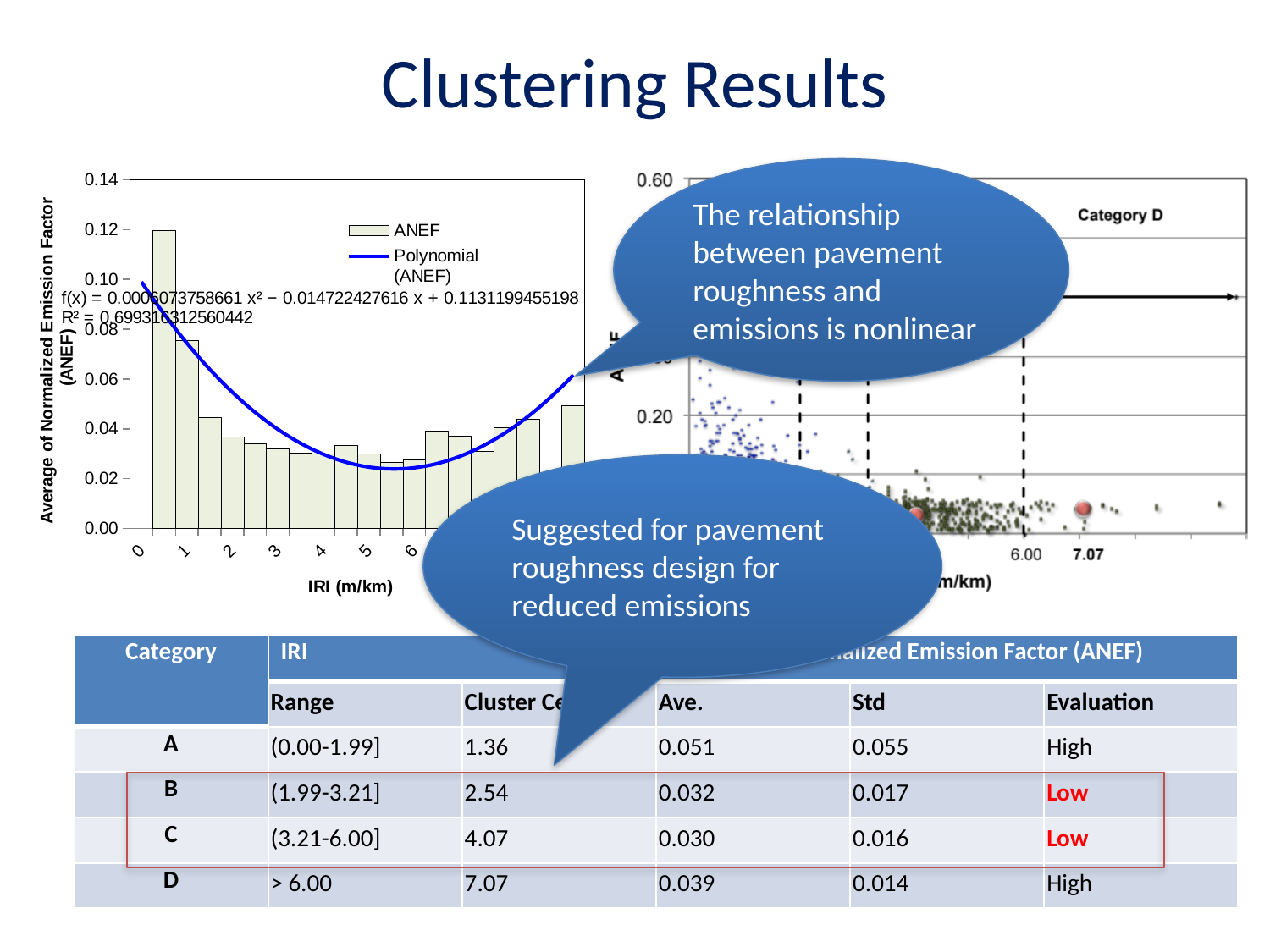
What kind of chart is the right chart on the slide? scatter plot What R² value is printed for the polynomial fit on the left chart? 0.699316312560442 On the left chart, is the ANEF bar at about IRI 5 greater or less than 0.04? less What are the two legend entries on the left chart? ANEF and Polynomial (ANEF) On the left chart, is the value of the first (tallest) ANEF bar near IRI 0 greater or less than 0.10? greater How many series does the legend of the left chart list? 2 On the left chart, do the ANEF bars generally rise or fall as IRI increases from 0 to 5? fall On the left chart, which bar has the highest ANEF value? the first bar, near IRI 0 On the left chart, do the ANEF bars generally rise or fall as IRI increases from 5 to 6.5? rise What is the x-axis title of the left chart? IRI (m/km) What kind of chart is the left chart showing ANEF against IRI? bar chart On the left chart, is the ANEF bar at about IRI 1.5 greater or less than 0.06? less